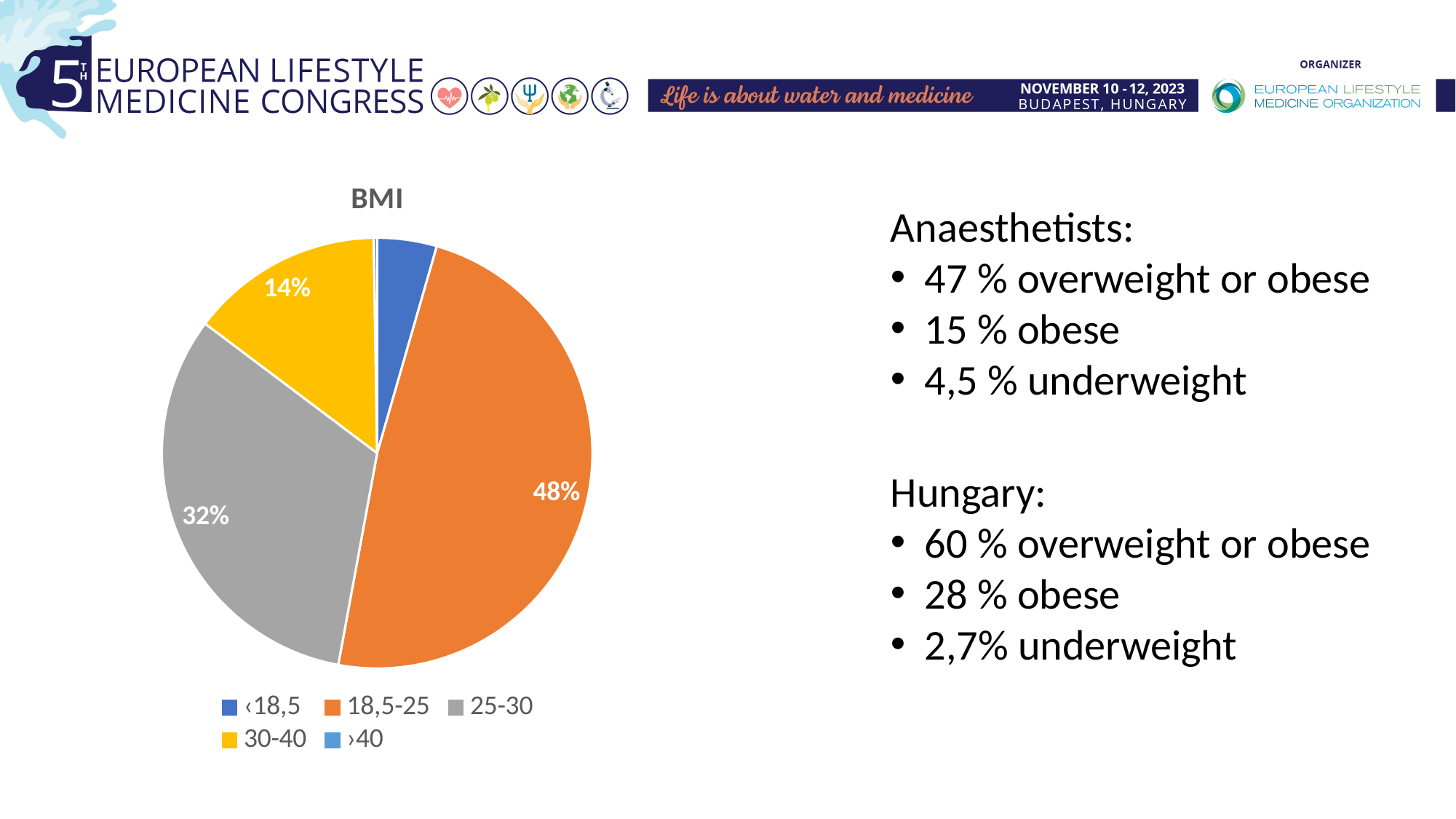
Which slice is larger, 25-30 or 30-40? 25-30 What kind of chart is shown on the slide? pie chart Which BMI category has the largest slice of the pie? 18,5-25 What share of the pie does the 18,5-25 BMI category have? 48% How many BMI categories does the pie chart show? 5 Which BMI category has the smallest slice of the pie? ›40 What colour is the slice for the 25-30 BMI category? grey What is the chart's title? BMI What is the difference between the 18,5-25 share and the 25-30 share? 16% What share of the pie does the 25-30 BMI category have? 32% How many entries does the legend list? 5 What share of the pie does the 30-40 BMI category have? 14%